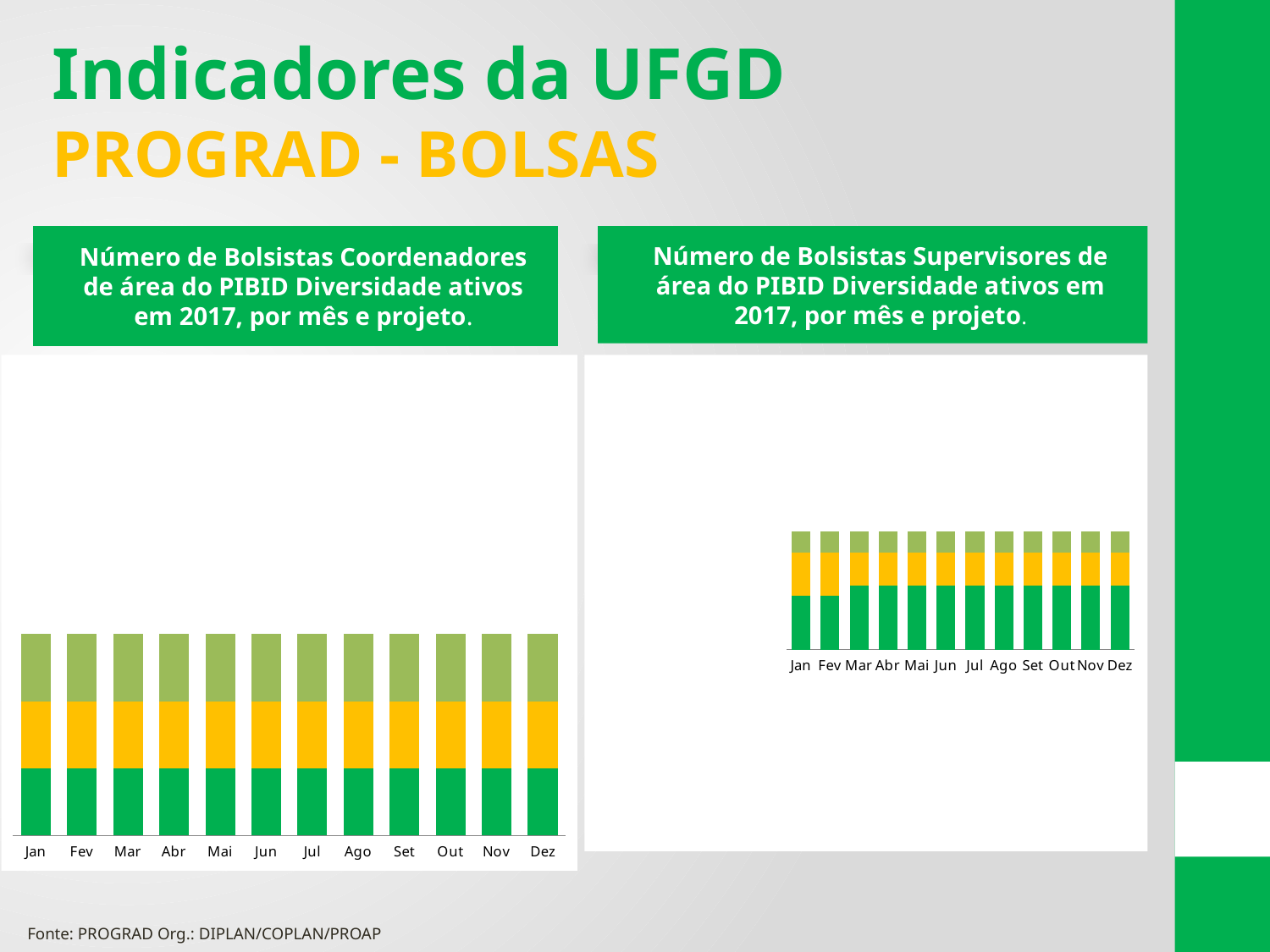
In the right chart (Bolsistas Supervisores), how many months are shown on the x axis? 12 In the right chart (Bolsistas Supervisores), how many coloured segments make up each stacked bar? 3 In the left chart (Bolsistas Coordenadores), how many coloured segments make up each stacked bar? 3 In the right chart (Bolsistas Supervisores), do the total bar heights rise, fall or stay the same from Jan to Dez? Stay the same What is the title of the right chart on the slide? Número de Bolsistas Supervisores de área do PIBID Diversidade ativos em 2017, por mês e projeto In the left chart (Bolsistas Coordenadores), what is the first month label on the x axis? Jan In the left chart (Bolsistas Coordenadores), do the total bar heights rise, fall or stay the same from Jan to Dez? Stay the same What kind of chart is the left chart, 'Número de Bolsistas Coordenadores de área do PIBID Diversidade ativos em 2017, por mês e projeto'? Stacked bar chart What kind of chart is the right chart, 'Número de Bolsistas Supervisores de área do PIBID Diversidade ativos em 2017, por mês e projeto'? Stacked bar chart